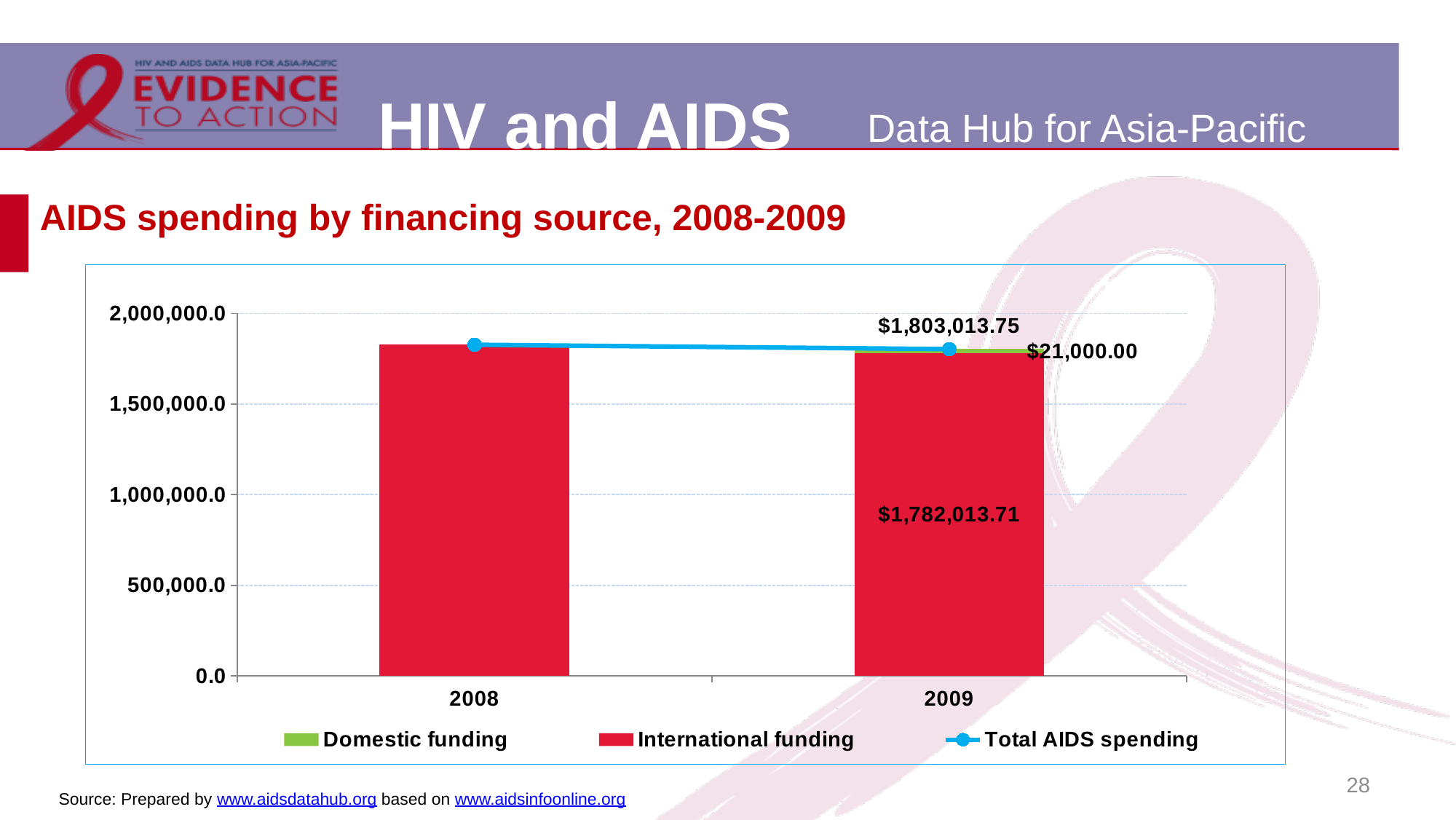
What is the title of the chart? AIDS spending by financing source, 2008-2009 In 2009, which is larger: Domestic funding or International funding? International funding Does the Total AIDS spending line rise or fall from 2008 to 2009? Fall What is the value of Domestic funding for 2009? $21,000.00 What is the Total AIDS spending for 2009? $1,803,013.75 How many years are shown on the x axis? 2 How many series does the legend list? 3 What is the difference between International funding and Domestic funding in 2009? $1,761,013.71 What is the value of International funding for 2009? $1,782,013.71 What kind of chart is this? Stacked bar chart with a line Is the International funding bar for 2008 greater or less than 2,000,000.0? less Is the International funding bar for 2008 greater or less than 1,500,000.0? greater